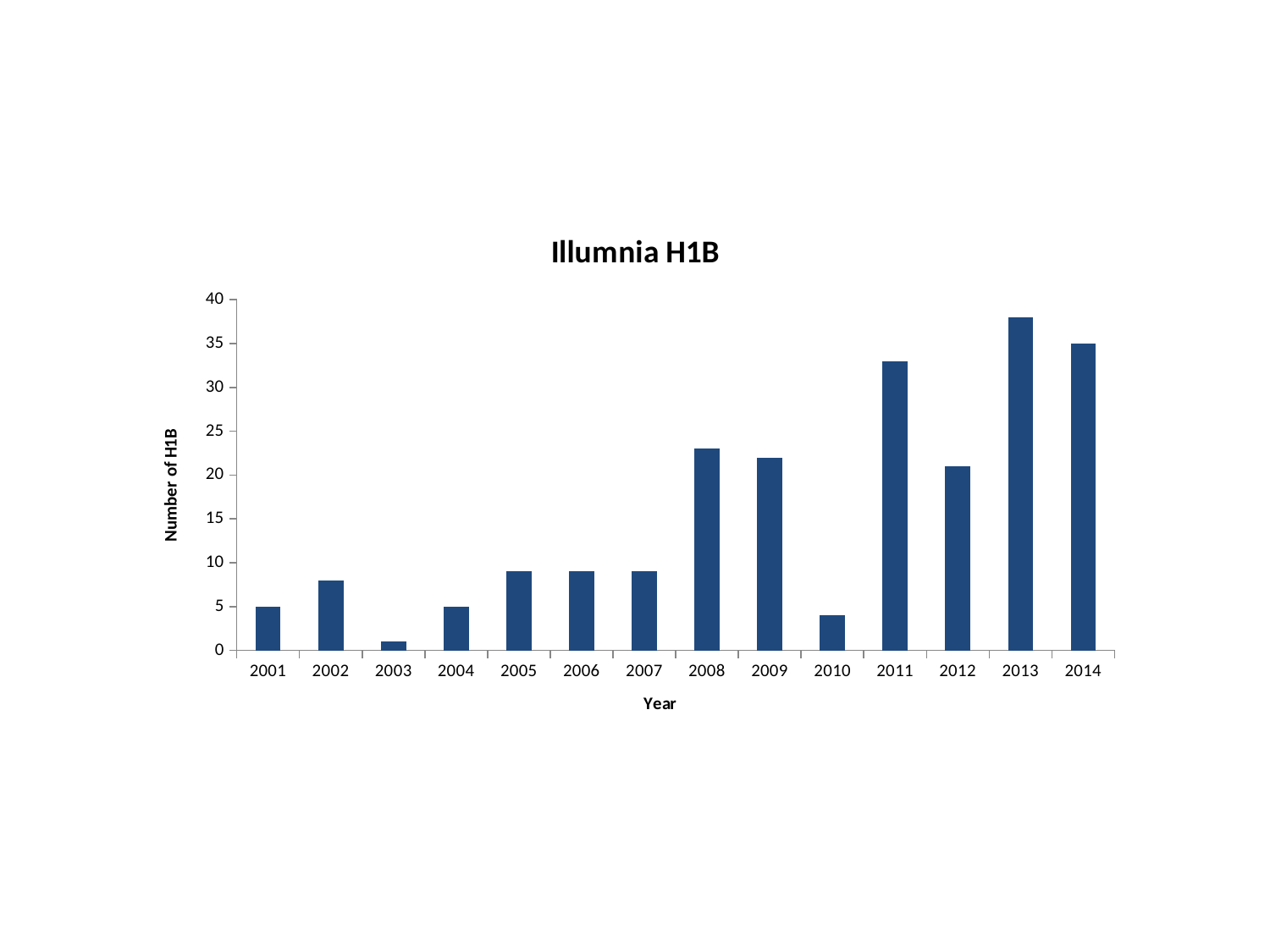
What is the label of the vertical axis? Number of H1B Do the values generally rise or fall from 2001 to 2014? rise What is the title of the chart? Illumnia H1B What type of chart is shown on the slide? bar chart Is the value for 2010 greater or less than 5? less Which year has the highest number of H1B? 2013 How many years are shown on the x axis? 14 Which year has the lowest number of H1B? 2003 Which is larger, the value for 2008 or the value for 2012? 2008 What is the number of H1B for 2001? 5 Is the value for 2013 greater or less than 35? greater What is the number of H1B for 2004? 5